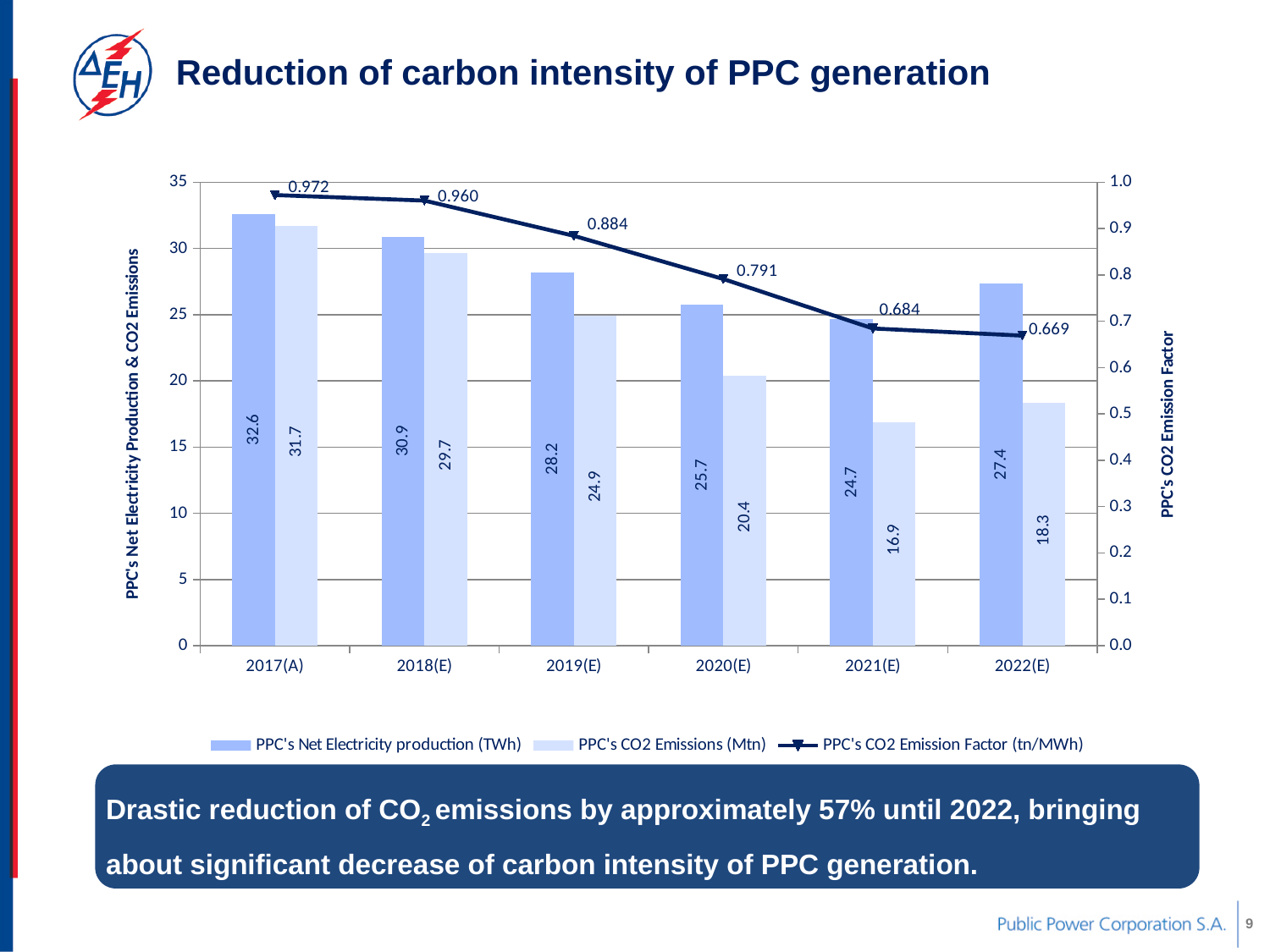
Which year has the highest PPC's CO2 Emissions (Mtn)? 2017(A) Is PPC's CO2 Emission Factor (tn/MWh) for 2022(E) greater or less than 0.7? less What kind of chart is used for PPC's CO2 Emission Factor (tn/MWh)? line chart What is the difference between PPC's CO2 Emissions (Mtn) in 2017(A) and 2022(E)? 13.4 What is PPC's CO2 Emission Factor (tn/MWh) for 2019(E)? 0.884 What is PPC's CO2 Emissions (Mtn) value for 2021(E)? 16.9 Does PPC's CO2 Emission Factor (tn/MWh) rise or fall from 2017(A) to 2022(E)? fall What is PPC's Net Electricity production (TWh) for 2017(A)? 32.6 Which is larger: PPC's Net Electricity production (TWh) in 2020(E) or in 2022(E)? 2022(E) How many years are shown on the x axis? 6 Which year has the lowest PPC's Net Electricity production (TWh)? 2021(E) How many series does the legend list? 3